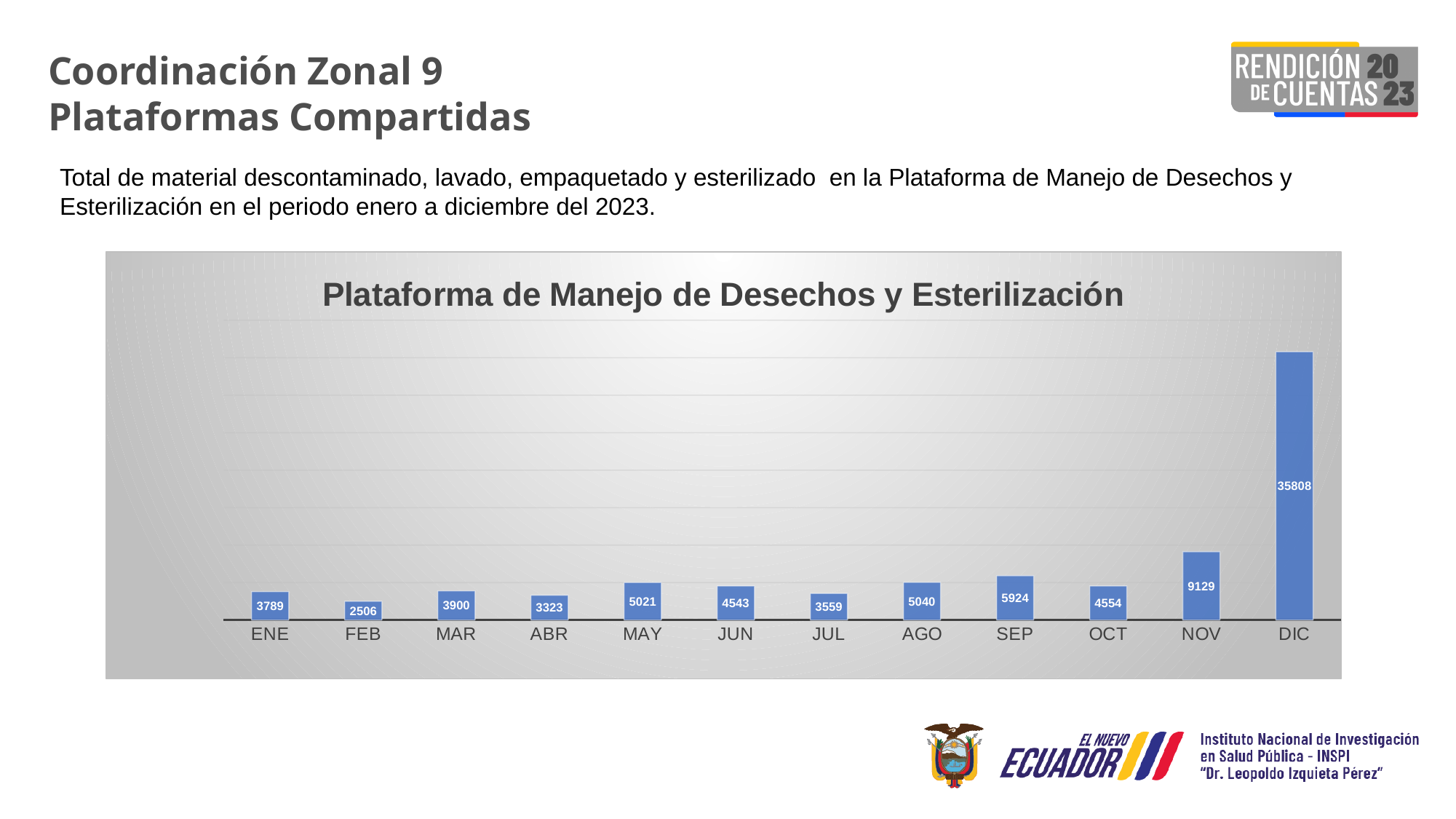
What is the difference between the values for DIC and NOV? 26679 What is the value for SEP? 5924 What is the title of the chart? Plataforma de Manejo de Desechos y Esterilización What is the difference between the values for MAY and ABR? 1698 Which is larger, the value for AGO or the value for JUL? AGO What is the value for DIC? 35808 What is the value for NOV? 9129 What kind of chart is this? bar chart How many months are shown on the x axis? 12 What is the value for FEB? 2506 Which month has the lowest value? FEB Which month has the highest value? DIC